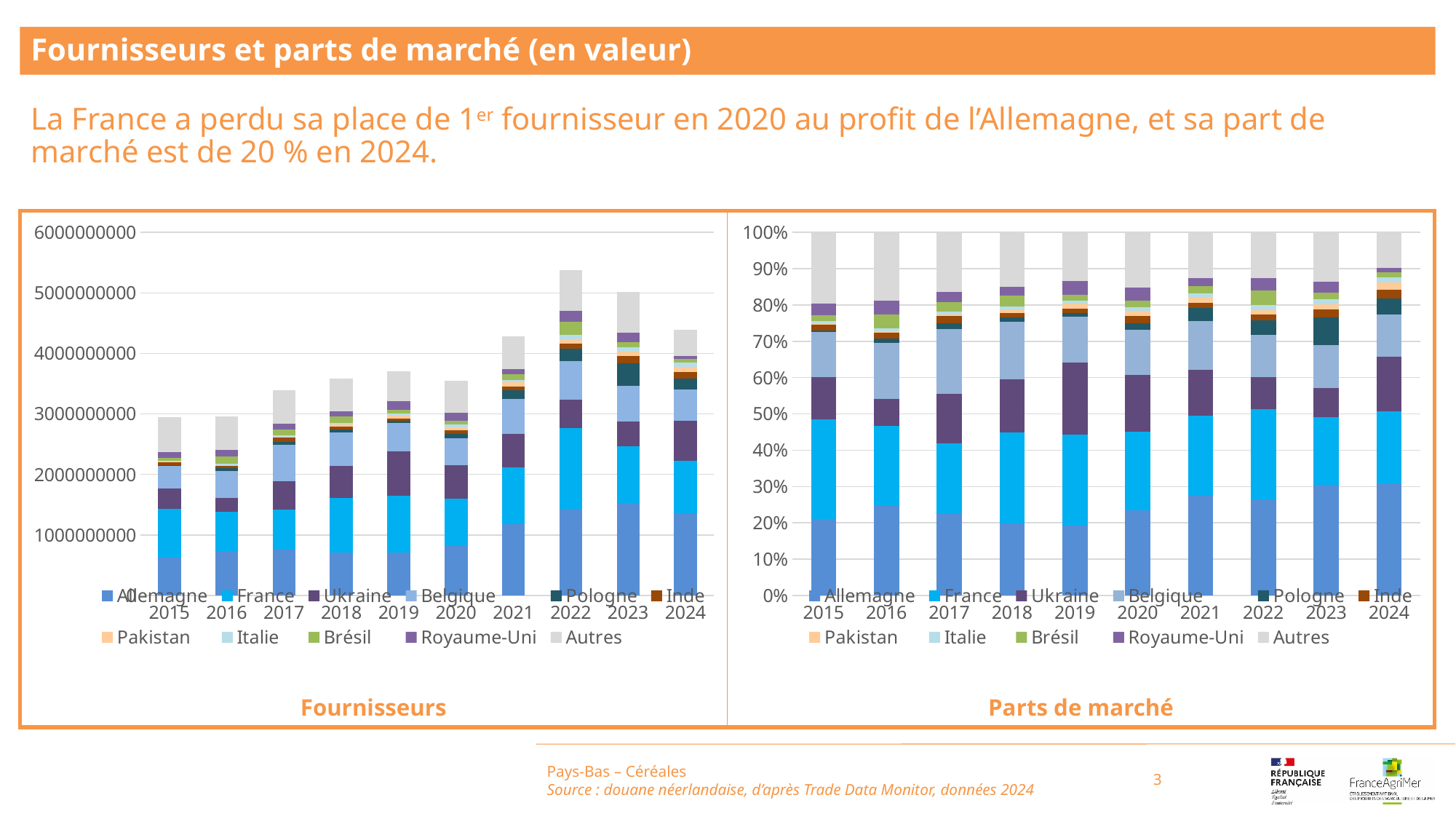
In the 'Fournisseurs' chart, which year has the tallest total bar? 2022 How many series does the legend of the 'Fournisseurs' chart list? 11 What kind of chart is the 'Fournisseurs' chart on the left? Stacked bar chart How many years are shown on the x axis of the 'Parts de marché' chart? 10 In the 'Parts de marché' chart, which is larger in 2024, the share of Allemagne or the share of France? Allemagne In the 'Fournisseurs' chart, is the total bar for 2022 greater or less than 5000000000? greater In the 'Fournisseurs' chart, is the total bar for 2024 greater or less than 5000000000? less In the 'Parts de marché' chart, is the share for Allemagne in 2015 greater or less than 30%? less In the 'Parts de marché' chart, which is larger in 2015, the share of Allemagne or the share of France? France What is the title of the chart on the right of the slide? Parts de marché